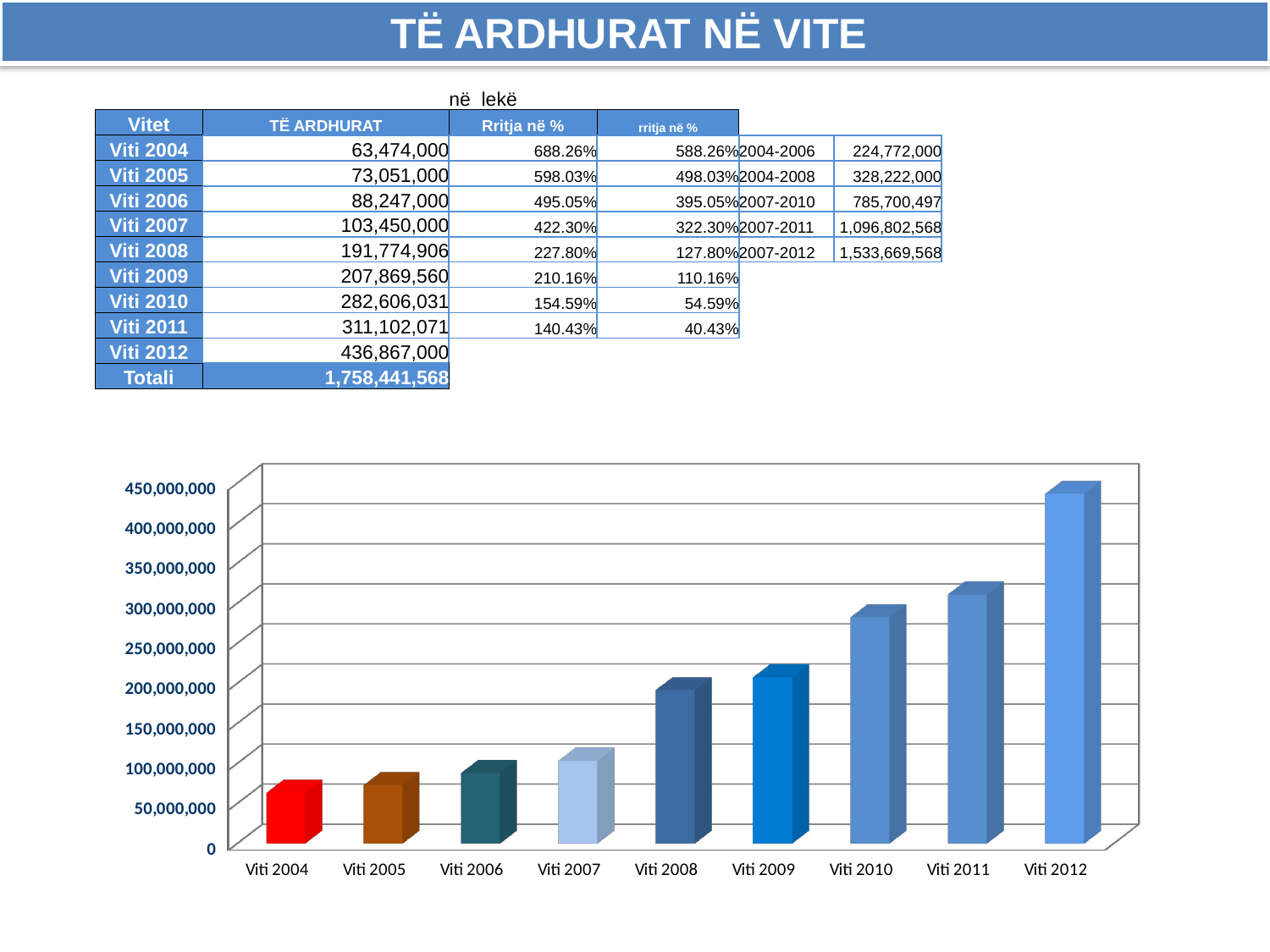
Which year has the shortest bar in the chart? Viti 2004 According to the slide, what is the value (TË ARDHURAT) for Viti 2008? 191,774,906 Which year has the tallest bar in the chart? Viti 2012 How many years (categories) are plotted on the chart? 9 What kind of chart is shown on the slide? bar chart What is the total (Totali) of all the yearly values shown on the slide? 1,758,441,568 According to the slide, what is the value (TË ARDHURAT) for Viti 2012? 436,867,000 Which bar is taller, Viti 2009 or Viti 2008? Viti 2009 Do the values in the chart rise or fall from Viti 2004 to Viti 2012? rise Is the bar for Viti 2012 greater or less than 400,000,000? greater What is the difference between the values for Viti 2012 and Viti 2011 shown on the slide? 125,764,929 Is the bar for Viti 2006 greater or less than 100,000,000? less